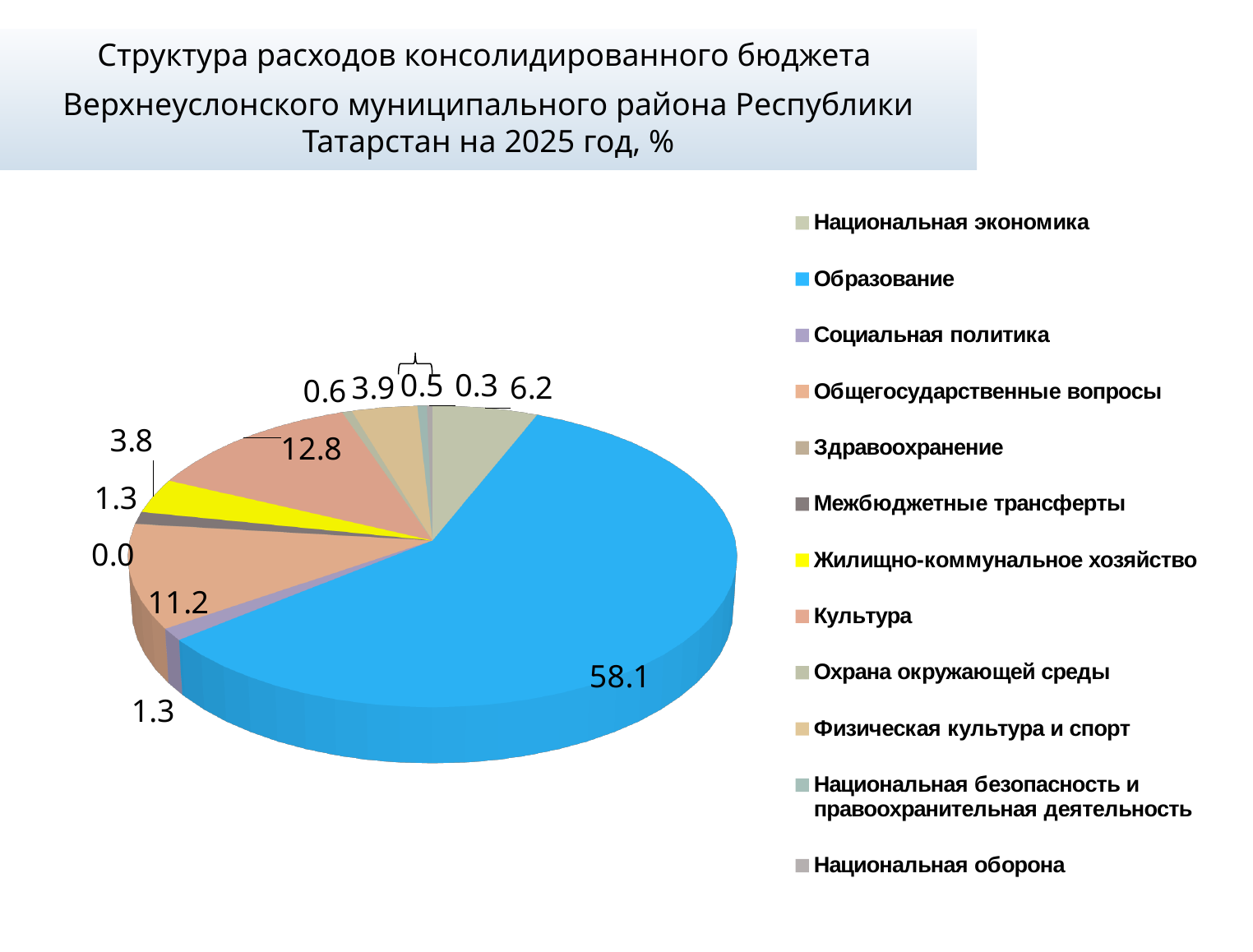
For which year does the chart show the structure of budget expenditure? 2025 What is the value shown for Жилищно-коммунальное хозяйство (the yellow slice)? 3.8 What is the difference between the shares of Образование and Культура? 45.3 What share of the consolidated budget expenditure goes to Образование? 58.1 What is the value shown for Культура? 12.8 Which category has the largest share of the budget expenditure? Образование Is the share for Образование greater or less than 50? greater What is the value shown for Национальная экономика? 6.2 What kind of chart is shown on the slide? pie chart What is the value shown for Общегосударственные вопросы? 11.2 How many categories does the legend list? 12 Which is larger, the share for Культура or for Общегосударственные вопросы? Культура